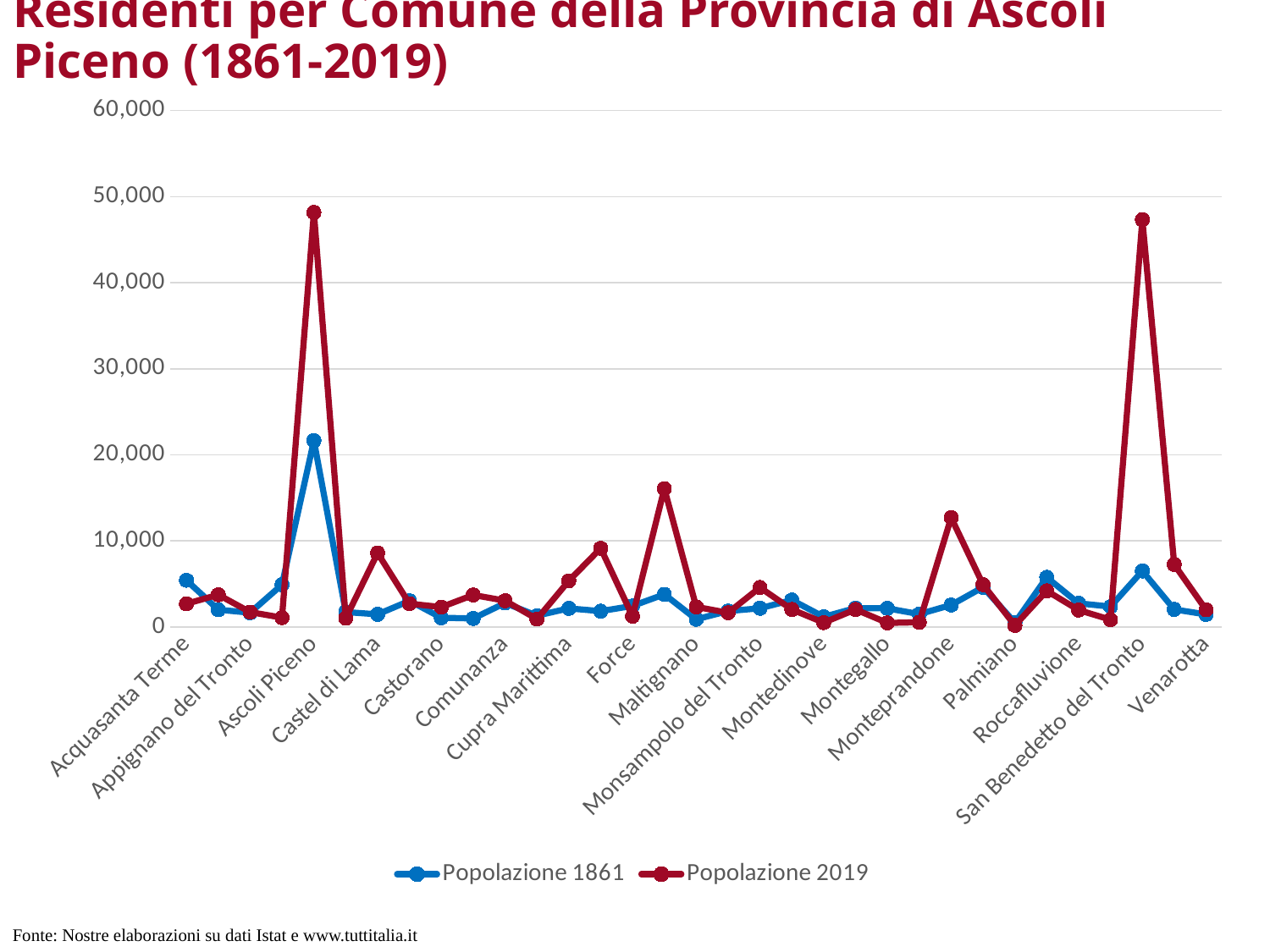
Is the Popolazione 2019 value for Force greater or less than 10,000? less For San Benedetto del Tronto, which series has the larger value, Popolazione 1861 or Popolazione 2019? Popolazione 2019 Is the Popolazione 2019 value for Ascoli Piceno greater or less than 40,000? greater Is the Popolazione 2019 value for San Benedetto del Tronto greater or less than 40,000? greater What kind of chart is shown on the slide? Line chart What are the two entries in the chart legend? Popolazione 1861 and Popolazione 2019 Which comune has the highest value for Popolazione 1861? Ascoli Piceno What is the title of the chart? Residenti per Comune della Provincia di Ascoli Piceno (1861-2019) For Acquasanta Terme, which series has the larger value, Popolazione 1861 or Popolazione 2019? Popolazione 1861 How many series does the legend list? 2